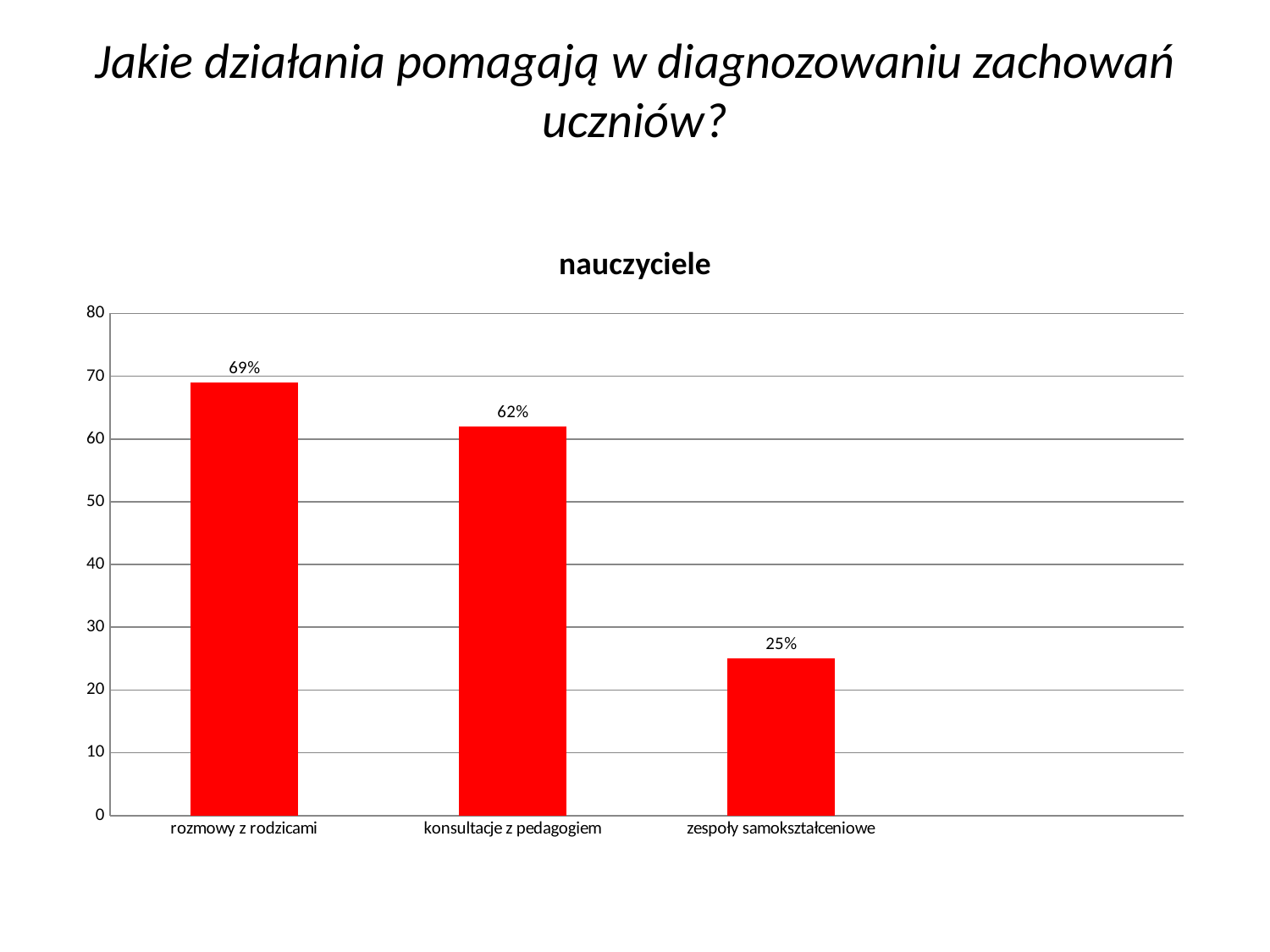
Is the value for zespoły samokształceniowe greater or less than 30? less Which category has the lowest value? zespoły samokształceniowe Which is larger, the value for konsultacje z pedagogiem or the value for zespoły samokształceniowe? konsultacje z pedagogiem What is the difference between the values for rozmowy z rodzicami and konsultacje z pedagogiem? 7% What is the title of the chart? nauczyciele Which category has the highest value? rozmowy z rodzicami What kind of chart is shown on the slide? bar chart What is the value for zespoły samokształceniowe? 25% How many categories are shown in the chart? 3 What is the value for rozmowy z rodzicami? 69% What is the difference between the values for konsultacje z pedagogiem and zespoły samokształceniowe? 37% What is the value for konsultacje z pedagogiem? 62%